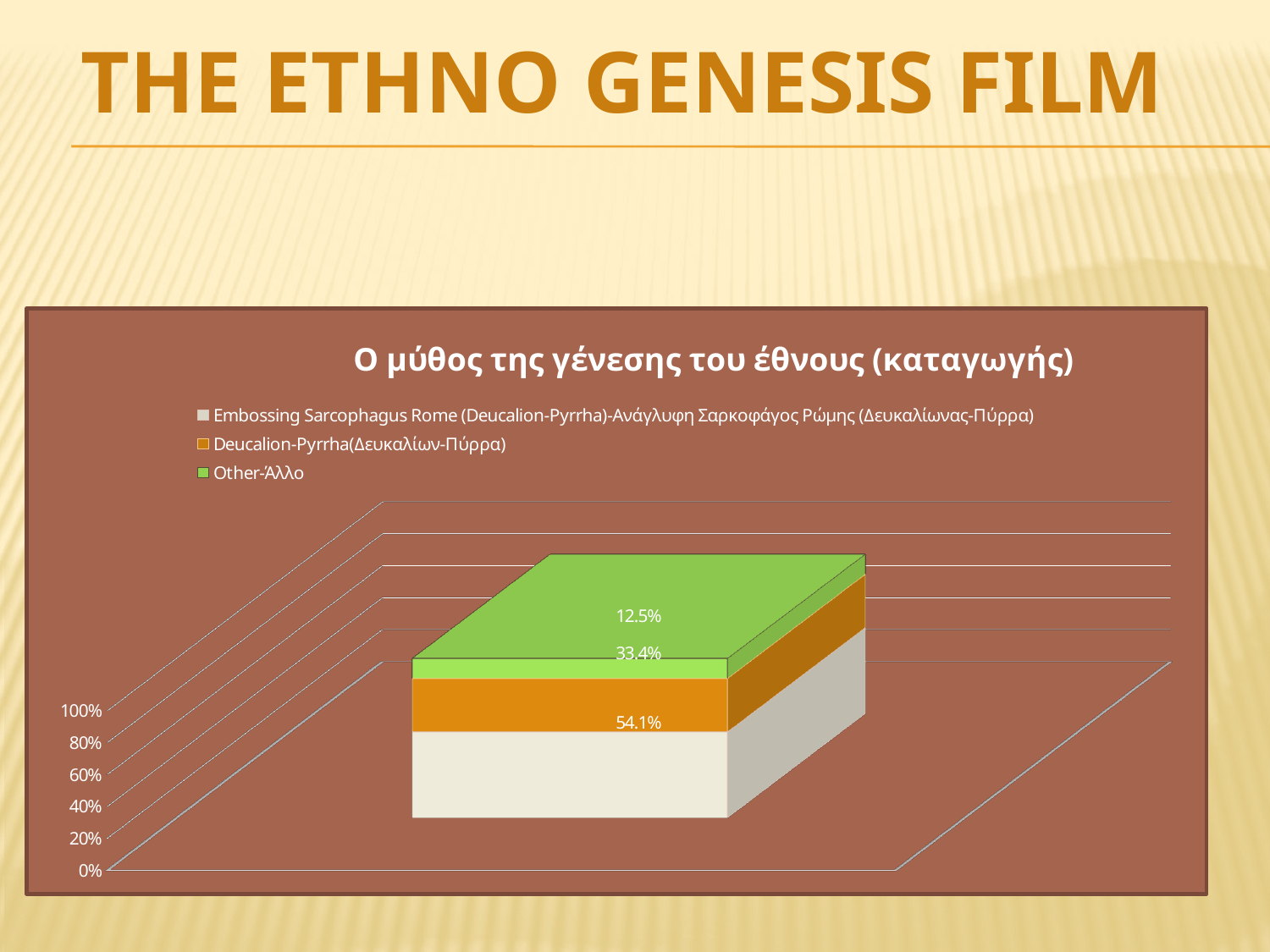
Which series has the highest value? Embossing Sarcophagus Rome (Deucalion-Pyrrha) What is the title of the chart? Ο μύθος της γένεσης του έθνους (καταγωγής) What kind of chart is shown on the slide? Stacked bar chart What is the value for the Deucalion-Pyrrha (Δευκαλίων-Πύρρα) series? 33.4% What is the value for the Embossing Sarcophagus Rome (Deucalion-Pyrrha) series? 54.1% Which series has the lowest value? Other-Άλλο What is the total of the stacked bar? 100% What is the difference between the Embossing Sarcophagus Rome value and the Deucalion-Pyrrha value? 20.7% Which is larger, the value for Deucalion-Pyrrha or the value for Other-Άλλο? Deucalion-Pyrrha Which colour represents the Other-Άλλο series in the legend? Green What is the value for the Other-Άλλο series? 12.5% How many series does the legend list? 3